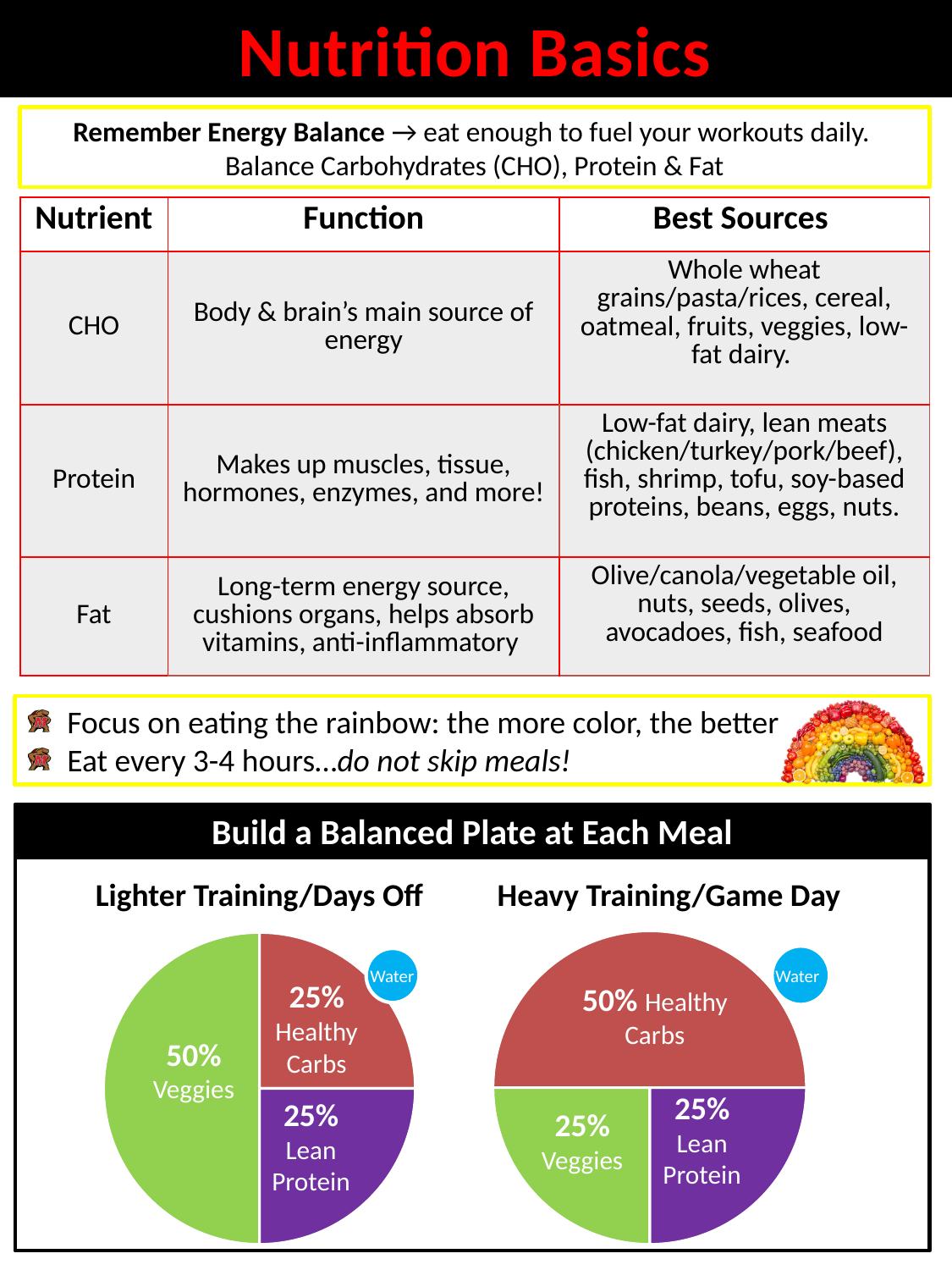
In the Lighter Training/Days Off chart, what is the difference between the Veggies share and the Healthy Carbs share? 25% In the Lighter Training/Days Off chart, what share of the plate is Lean Protein? 25% In the Heavy Training/Game Day chart, what colour is the Lean Protein slice? Purple What is the title of the section containing the two pie charts? Build a Balanced Plate at Each Meal In the Lighter Training/Days Off chart, what share of the plate is Veggies? 50% In the Heavy Training/Game Day chart, which is larger: the Healthy Carbs share or the Lean Protein share? Healthy Carbs In the Heavy Training/Game Day chart, what share of the plate is Healthy Carbs? 50% What kind of chart is the Heavy Training/Game Day chart? Pie chart In the Heavy Training/Game Day chart, which category has the largest share? Healthy Carbs In the Heavy Training/Game Day chart, what share of the plate is Veggies? 25% In the Lighter Training/Days Off chart, which category has the largest share? Veggies How many slices does the Lighter Training/Days Off chart have? 3